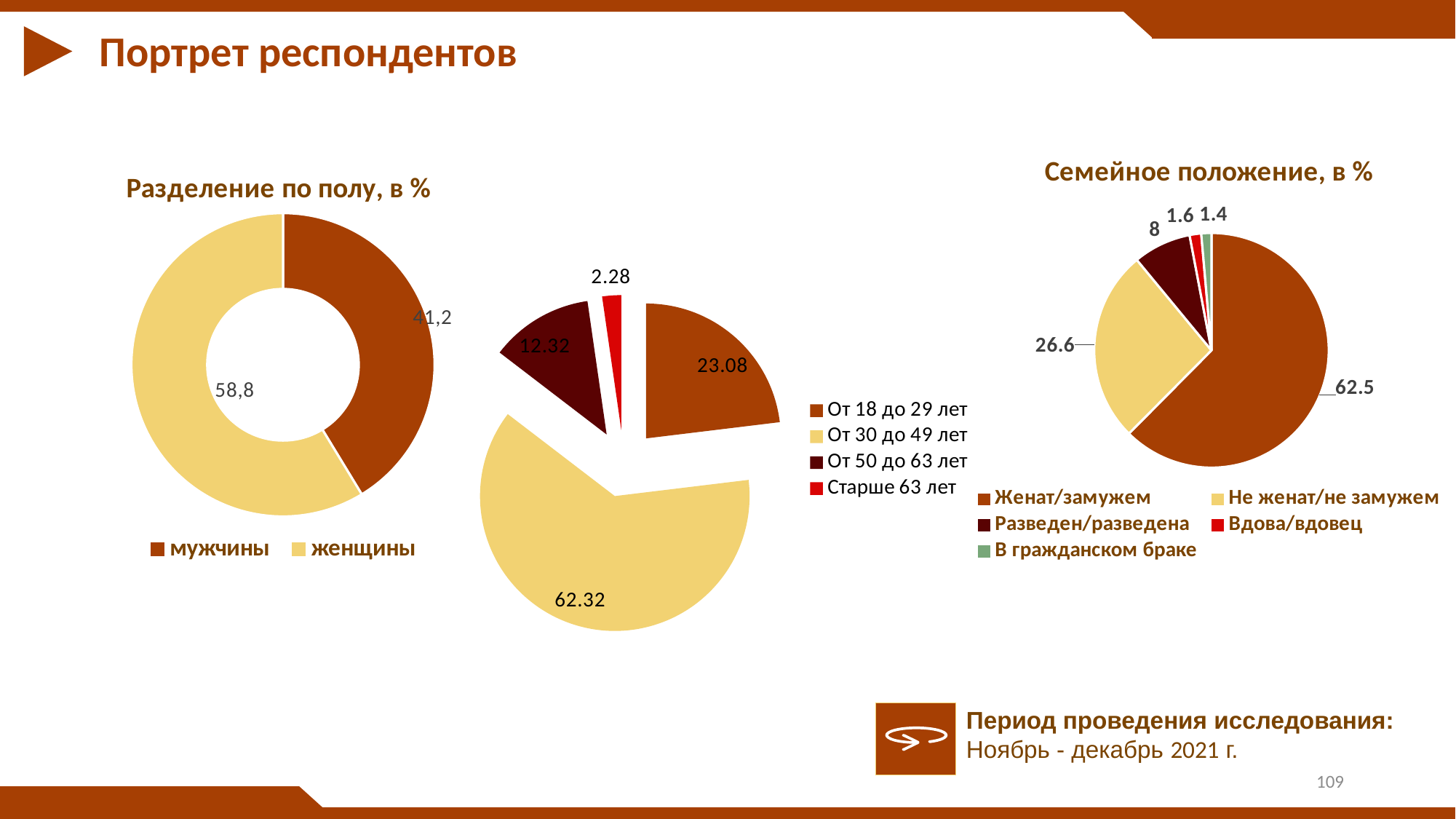
In the chart titled "Разделение по полу, в %", what is the value for мужчины? 41,2 In the chart titled "Разделение по полу, в %", what is the value for женщины? 58,8 In the chart titled "Разделение по полу, в %", which category is larger, мужчины or женщины? женщины In the middle pie chart (age groups), how many categories does the legend list? 4 In the middle pie chart (age groups), what is the value for От 30 до 49 лет? 62.32 In the chart titled "Семейное положение, в %", what is the difference between the values for Женат/замужем and Разведен/разведена? 54.5 In the chart titled "Семейное положение, в %", what is the value for Не женат/не замужем? 26.6 In the chart titled "Разделение по полу, в %", what is the difference between the values for женщины and мужчины? 17,6 In the middle pie chart (age groups), which category has the smallest share? Старше 63 лет What type of chart is the one titled "Семейное положение, в %"? Pie chart In the chart titled "Семейное положение, в %", which category has the largest share? Женат/замужем In the middle pie chart (age groups), what is the value for Старше 63 лет? 2.28